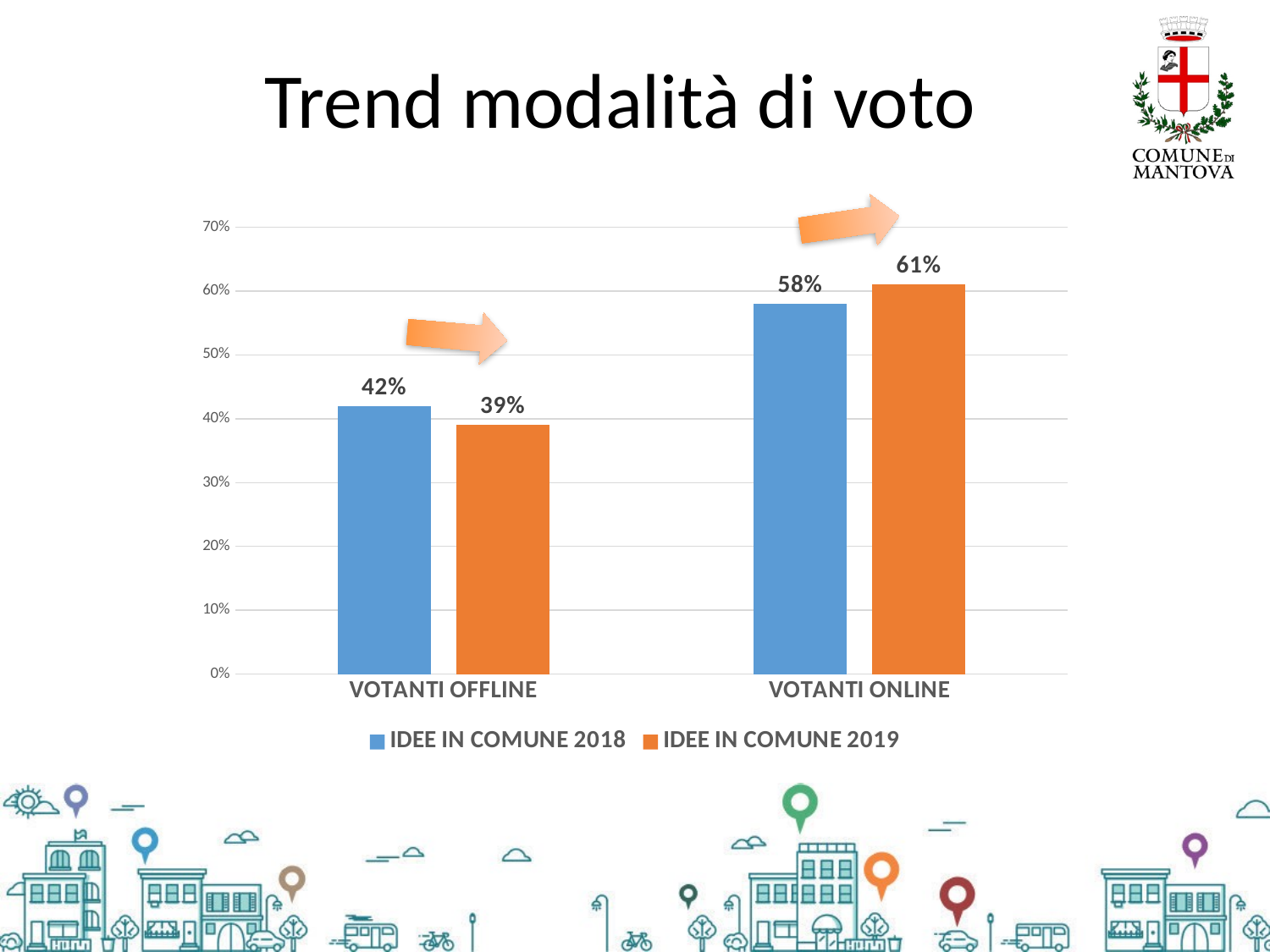
What is the value for VOTANTI ONLINE in the IDEE IN COMUNE 2018 series? 58% Which is larger for VOTANTI OFFLINE: the IDEE IN COMUNE 2018 value or the IDEE IN COMUNE 2019 value? IDEE IN COMUNE 2018 Which category has the lowest value in the IDEE IN COMUNE 2018 series? VOTANTI OFFLINE What is the value for VOTANTI OFFLINE in the IDEE IN COMUNE 2019 series? 39% What is the difference between the IDEE IN COMUNE 2018 and IDEE IN COMUNE 2019 values for VOTANTI OFFLINE? 3% What is the value for VOTANTI ONLINE in the IDEE IN COMUNE 2019 series? 61% What kind of chart is shown on the slide? Bar chart How many series does the legend list? 2 What is the value for VOTANTI OFFLINE in the IDEE IN COMUNE 2018 series? 42% How many categories are shown on the x axis? 2 What is the difference between the IDEE IN COMUNE 2019 and IDEE IN COMUNE 2018 values for VOTANTI ONLINE? 3% Which category has the highest value in the IDEE IN COMUNE 2019 series? VOTANTI ONLINE